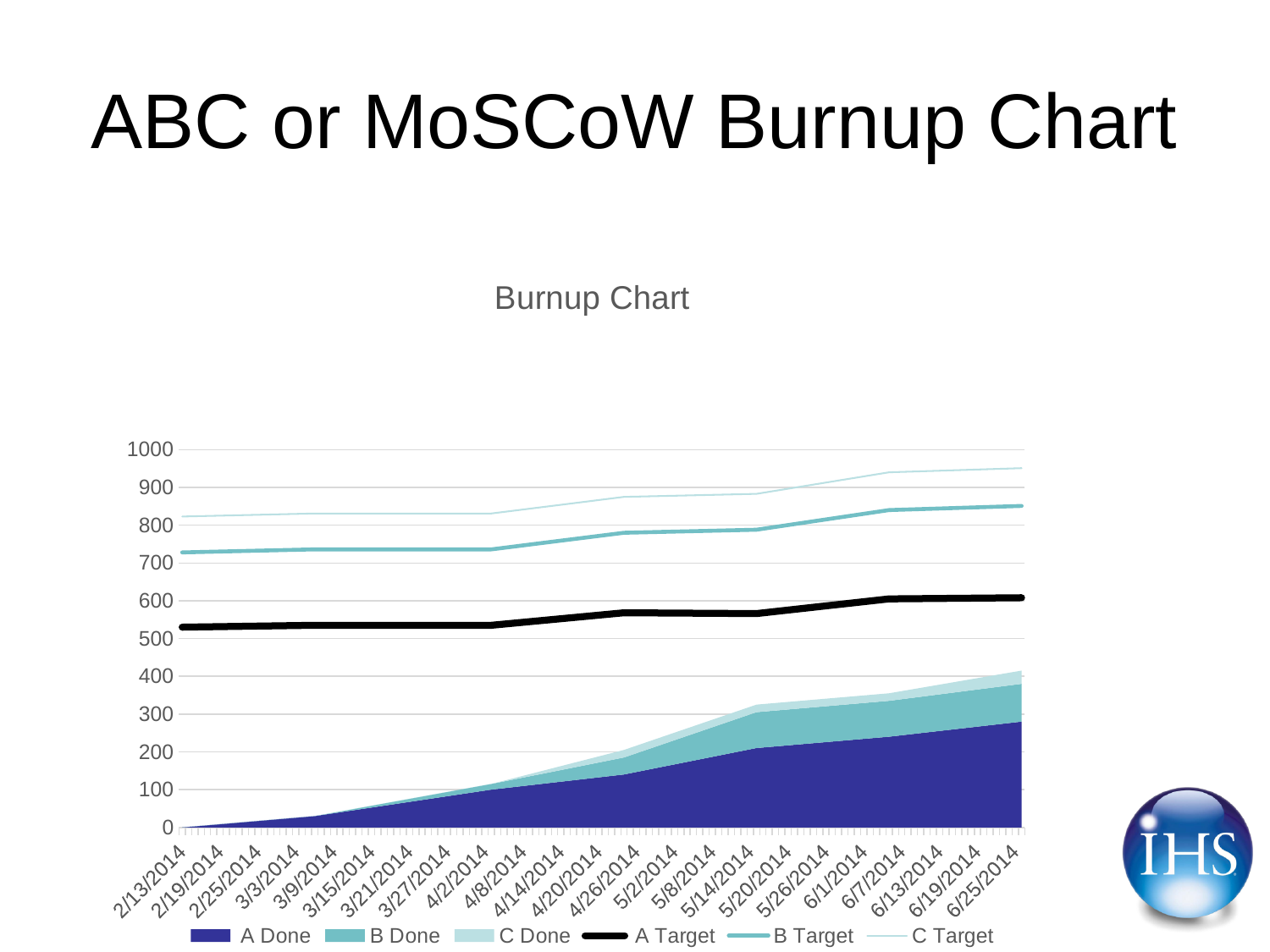
Which of the three target lines is the highest on the chart? C Target How many series does the chart legend list? 6 Is the value of C Target on 6/25/2014 greater or less than 900? greater On 6/25/2014, which is larger: A Target or B Target? B Target Is the value of A Target on 2/13/2014 greater or less than 500? greater Does the A Target line rise or fall from 2/13/2014 to 6/25/2014? rise What kind of chart is this? Combination of a stacked area chart and line chart What is the title of the chart? Burnup Chart Is the value of A Done on 6/25/2014 greater or less than 200? greater What is the first date label on the x axis? 2/13/2014 How many date labels are shown on the x axis? 23